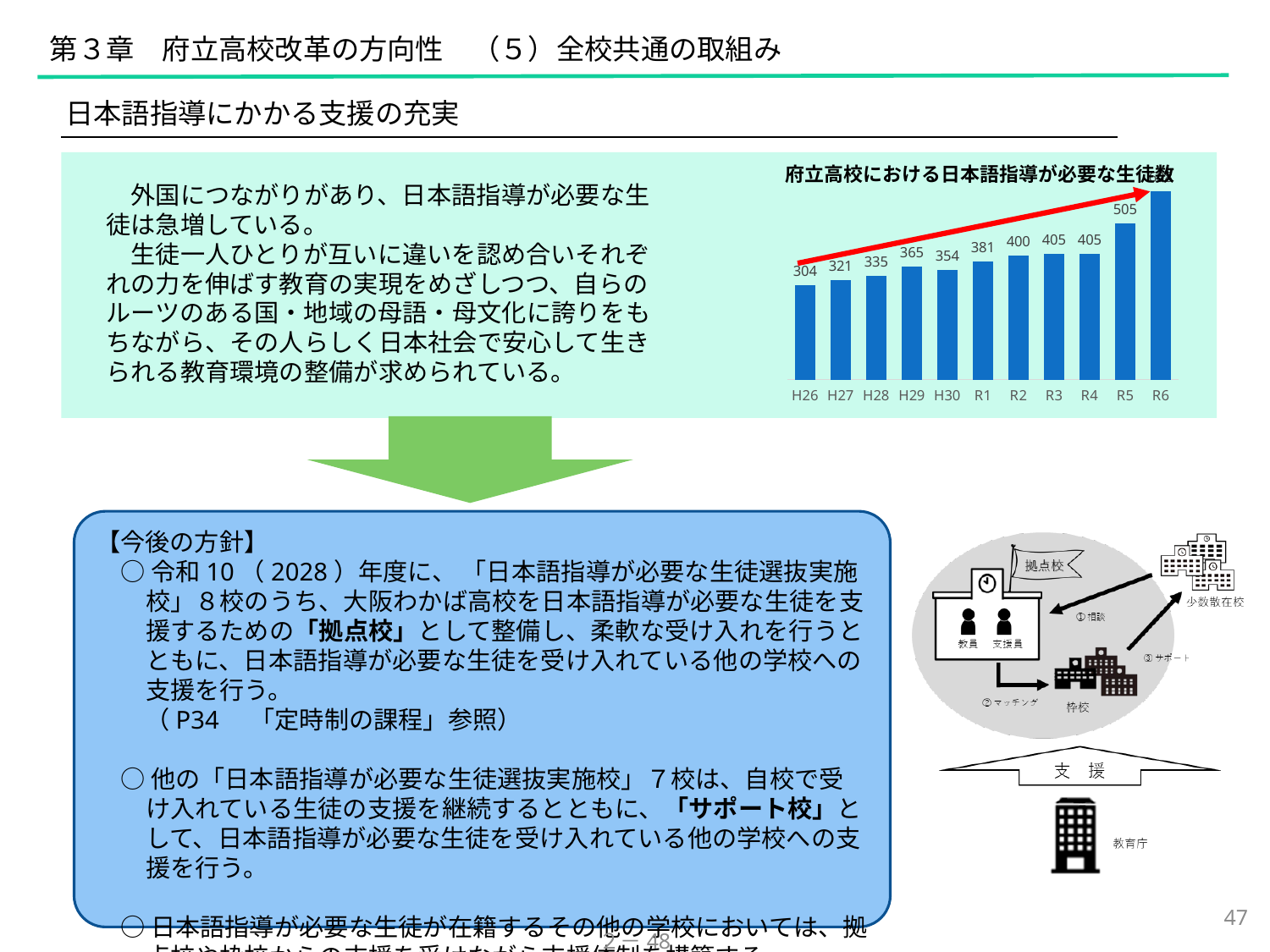
What is the difference between the values for R5 and R4? 100 Which category has the lowest value in the chart? H26 How many categories are shown on the x axis of the chart? 11 Which category has the highest bar in the chart? R6 Do the values generally rise or fall from H26 to R6? rise What is the value for H26 in the chart 府立高校における日本語指導が必要な生徒数? 304 What is the value for R2 in the chart? 400 What is the value for H30 in the chart? 354 What is the value for R5 in the chart? 505 Which is larger, the value for H29 or the value for H30? H29 What is the difference between the values for H29 and H30? 11 What kind of chart is shown on the slide? bar chart